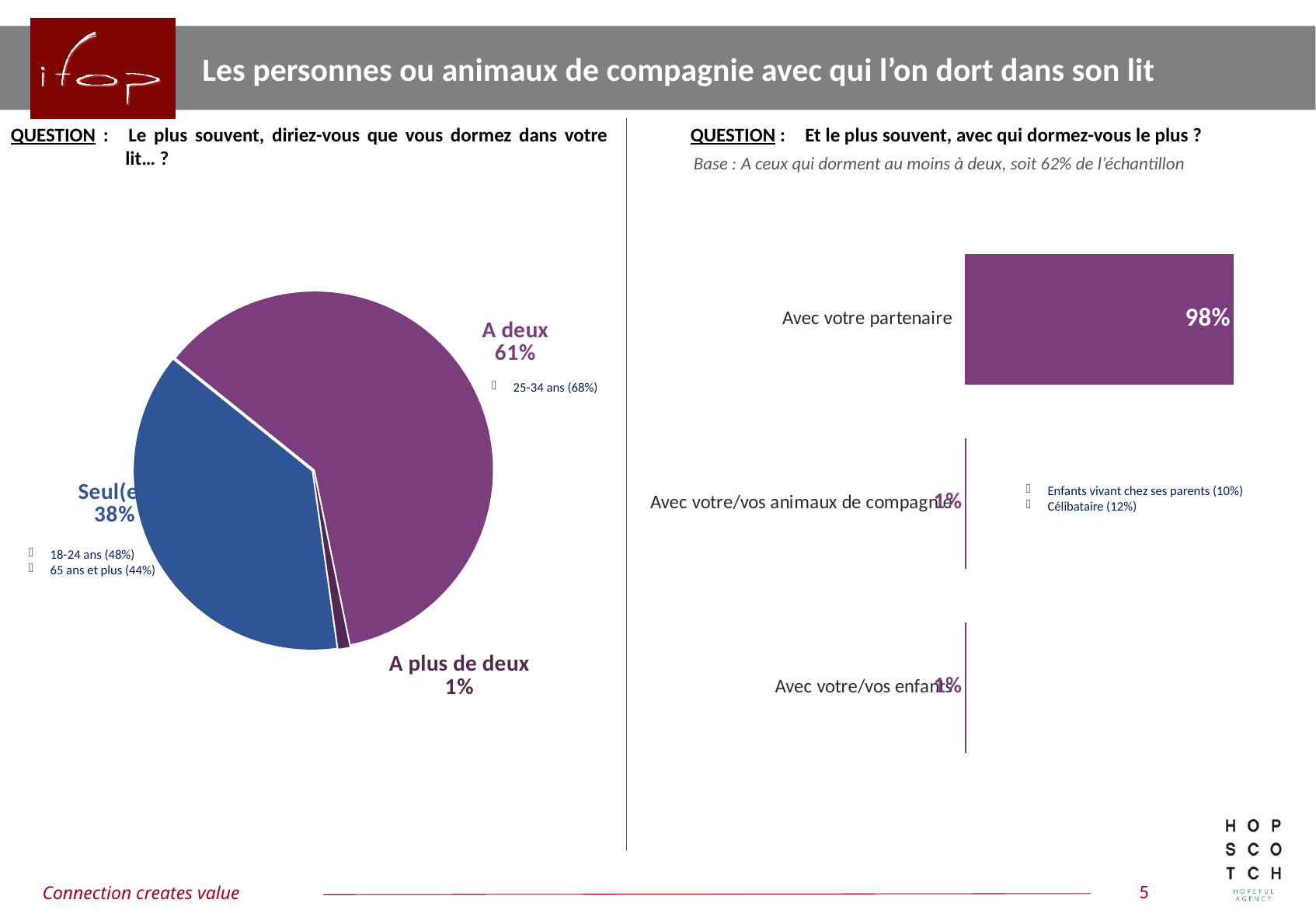
On the bar chart on the right, what is the value for 'Avec votre partenaire'? 98% What kind of chart is shown on the right side of the slide? Bar chart What kind of chart is shown on the left side of the slide? Pie chart On the pie chart on the left, which slice is the largest? A deux On the bar chart on the right, which category has the highest value? Avec votre partenaire On the pie chart on the left, which slice is the smallest? A plus de deux On the pie chart on the left, what share is labelled 'A deux'? 61% On the pie chart on the left, how many slices are there? 3 On the bar chart on the right, what is the value for 'Avec votre/vos enfants'? 1% On the pie chart on the left, what share is labelled 'Seul(e)'? 38% On the pie chart on the left, what share is labelled 'A plus de deux'? 1% On the pie chart on the left, what is the difference between the 'A deux' and 'Seul(e)' shares? 23 percentage points